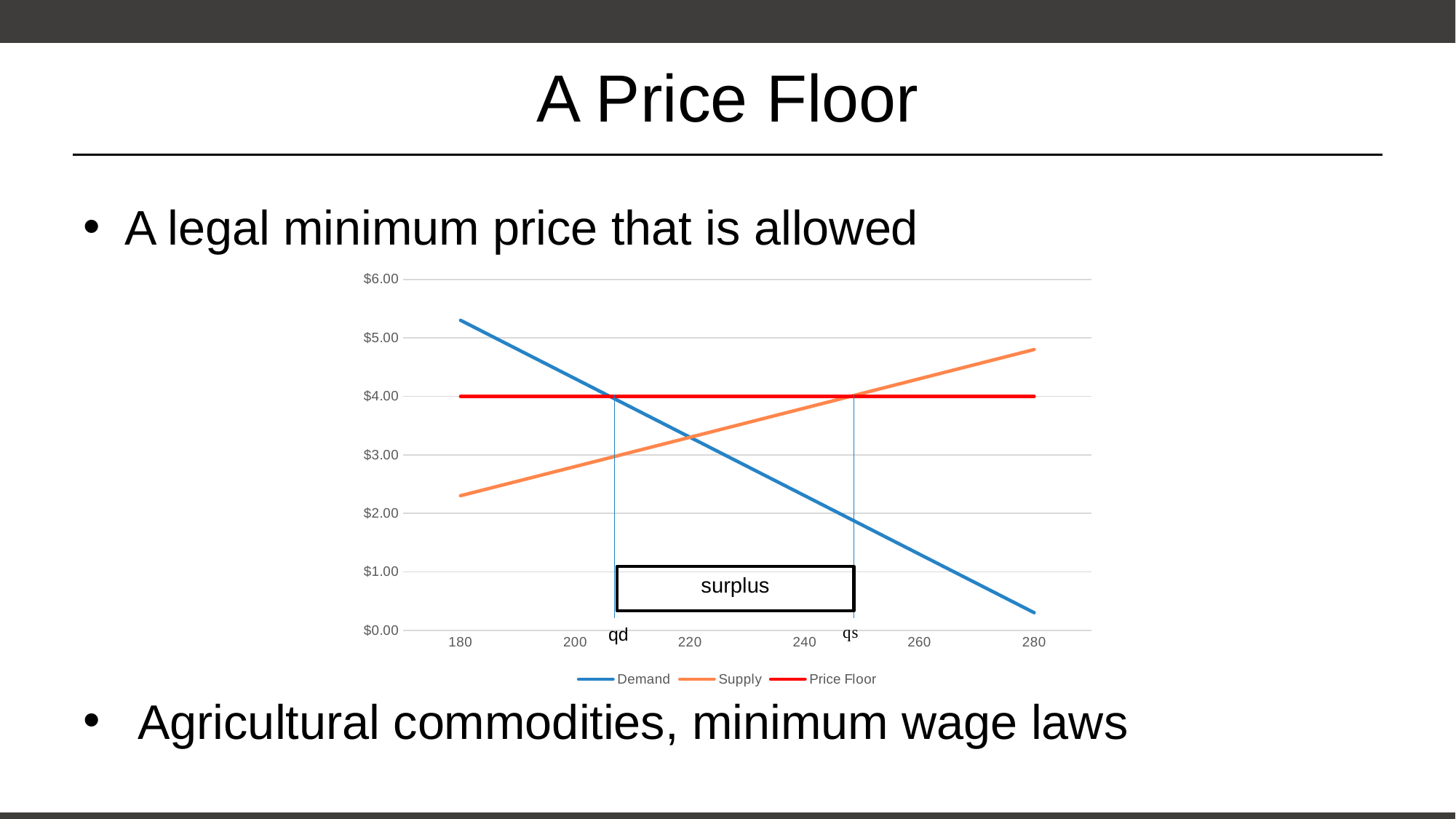
Is the Supply value at quantity 180 greater or less than $3.00? less Does the Demand line rise or fall as quantity increases along the x axis? fall What are the series names listed in the legend? Demand, Supply, Price Floor Does the Supply line rise or fall as quantity increases along the x axis? rise At quantity 180, which is higher, Demand or Supply? Demand At what price is the Price Floor line drawn? $4.00 What kind of chart is shown on the slide? line chart Is the Demand value at quantity 180 greater or less than $5.00? greater At quantity 280, which is higher, Demand or Supply? Supply How many series does the legend list? 3 Is the Demand value at quantity 280 greater or less than $1.00? less